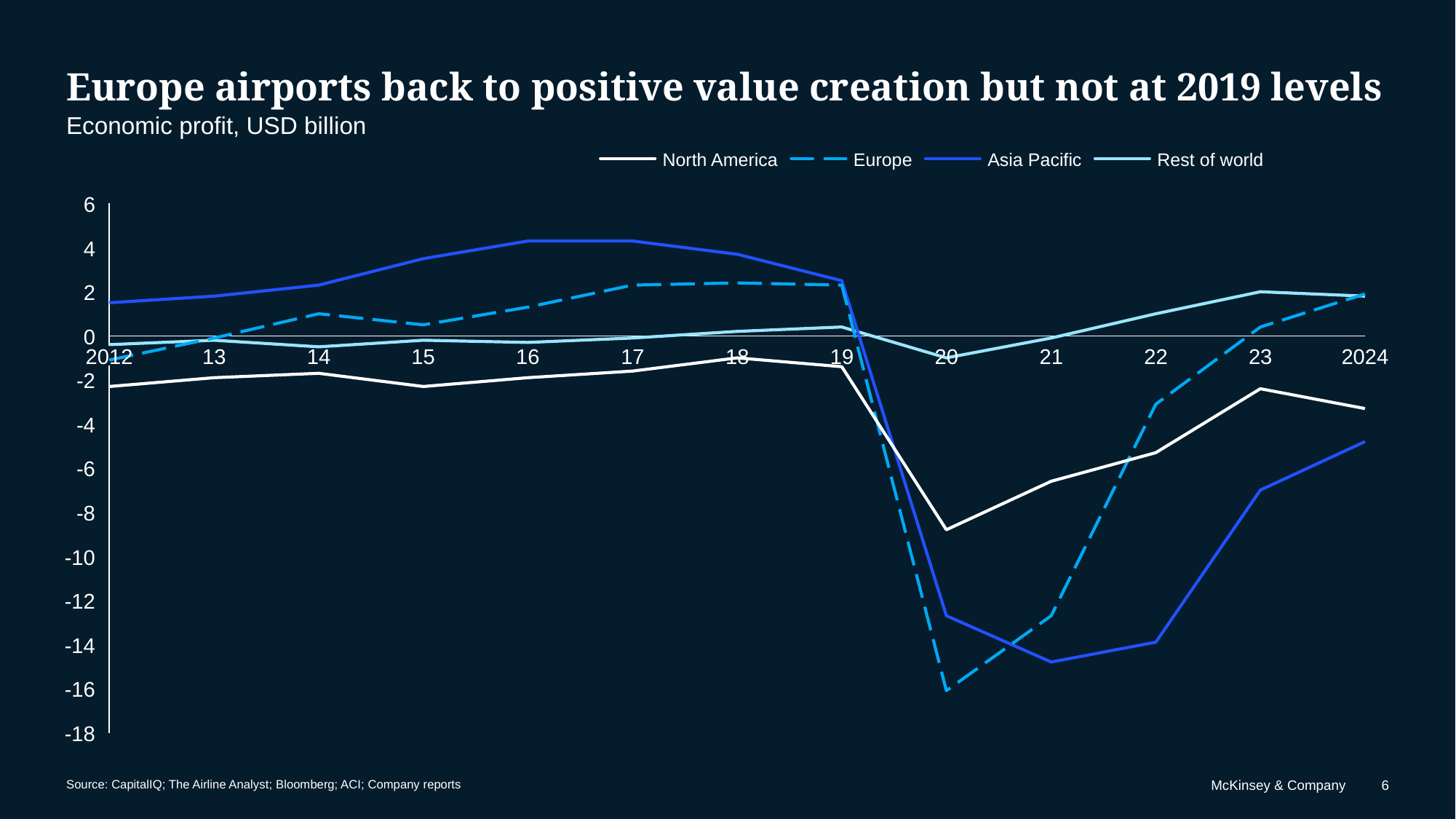
Does the North America series rise or fall from 2020 to 2023? Rise Which series has the lowest value in 2020? Europe Is the value for Europe in 2020 greater or less than -14? less How many years are plotted along the x axis? 13 In which year does the Europe series reach its lowest value? 2020 Is the value for North America in 2020 greater or less than -8? less Is the value for Asia Pacific in 2016 greater or less than 4? greater In 2024, which is larger: the value for Europe or the value for North America? Europe How many series does the legend list? 4 What unit is the economic profit measured in, according to the subtitle? USD billion What kind of chart is shown on the slide? Line chart